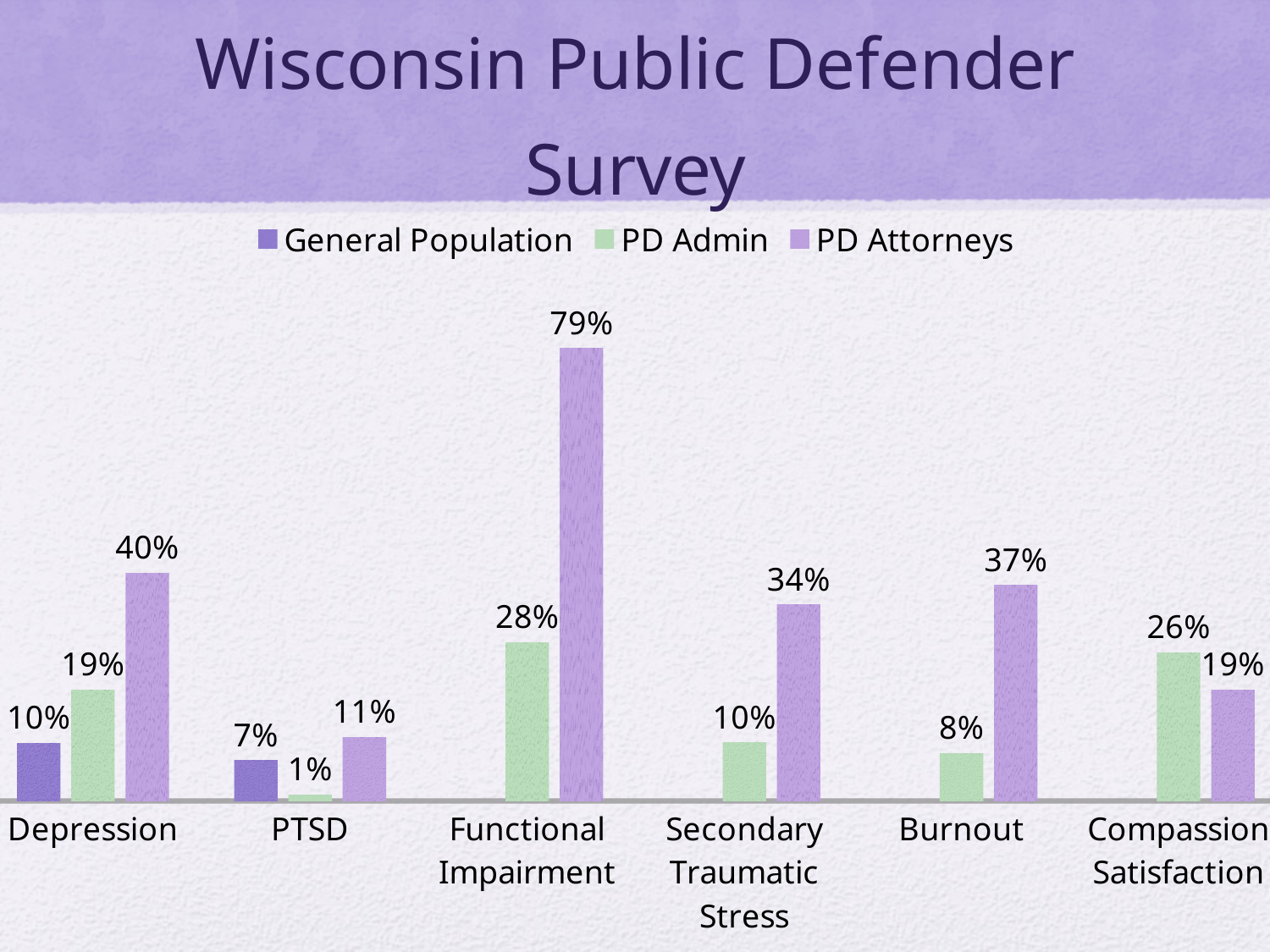
Which is larger for Compassion Satisfaction, PD Admin or PD Attorneys? PD Admin What is the PD Admin value for Compassion Satisfaction? 26% What is the difference between the PD Attorneys and PD Admin values for Burnout? 29% What is the General Population value for Depression? 10% What kind of chart is shown on the slide? Bar chart How many series does the legend list? 3 Which category has the lowest PD Admin value? PTSD What is the title of the chart? Wisconsin Public Defender Survey How many categories are shown on the x axis? 6 What is the PD Admin value for PTSD? 1% Which category has the highest PD Attorneys value? Functional Impairment What is the PD Attorneys value for Functional Impairment? 79%